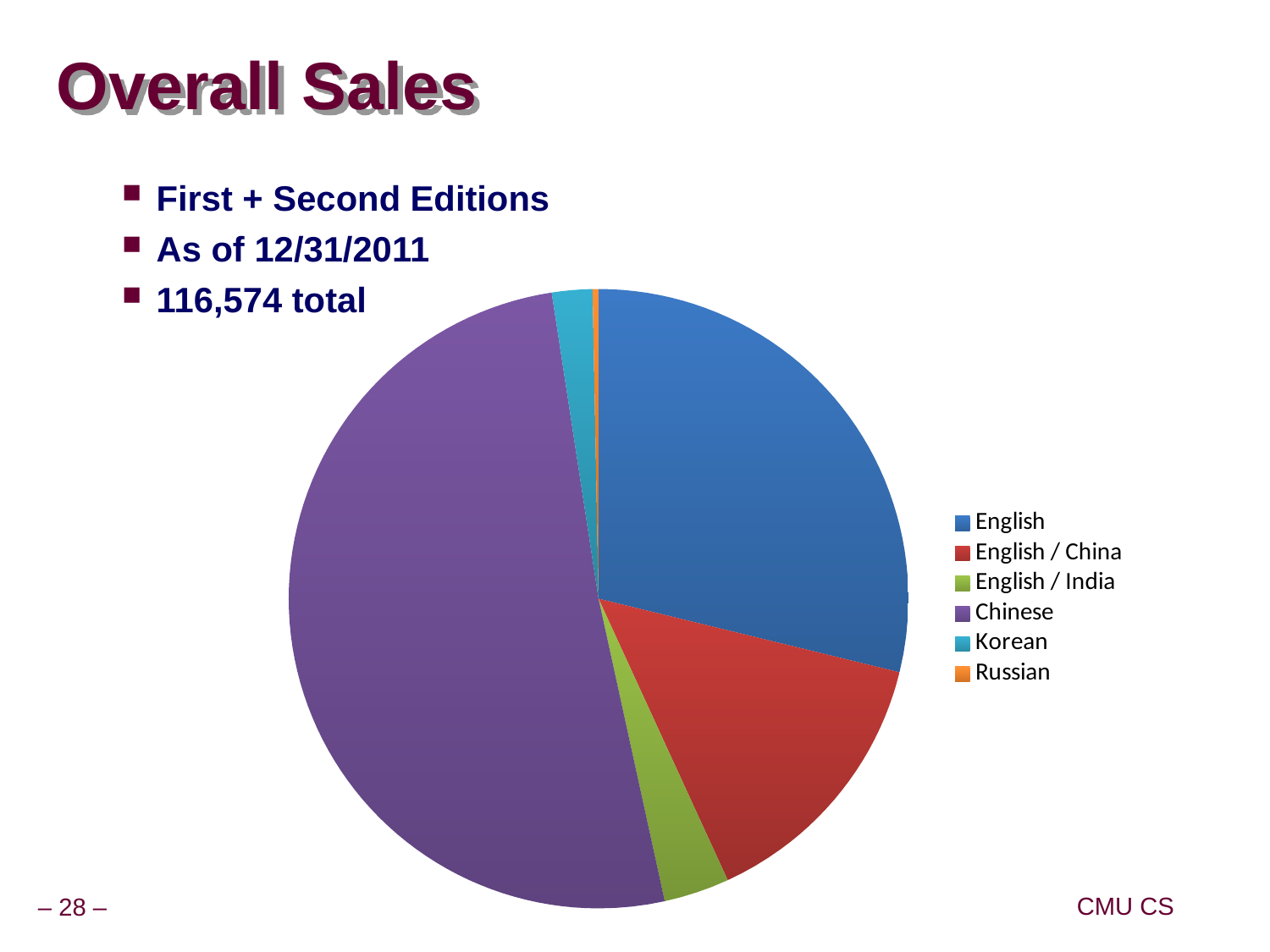
Which category has the largest slice of the pie chart? Chinese Which slice is larger, English or English / China? English Which slice is larger, English / China or English / India? English / China How many slices does the pie chart have? 6 What colour is the Chinese slice in the pie chart? purple Which slice is larger, Korean or Russian? Korean How many entries does the legend of the pie chart list? 6 What is the title of the slide containing the pie chart? Overall Sales Which category has the smallest slice of the pie chart? Russian What kind of chart is shown on the slide? pie chart